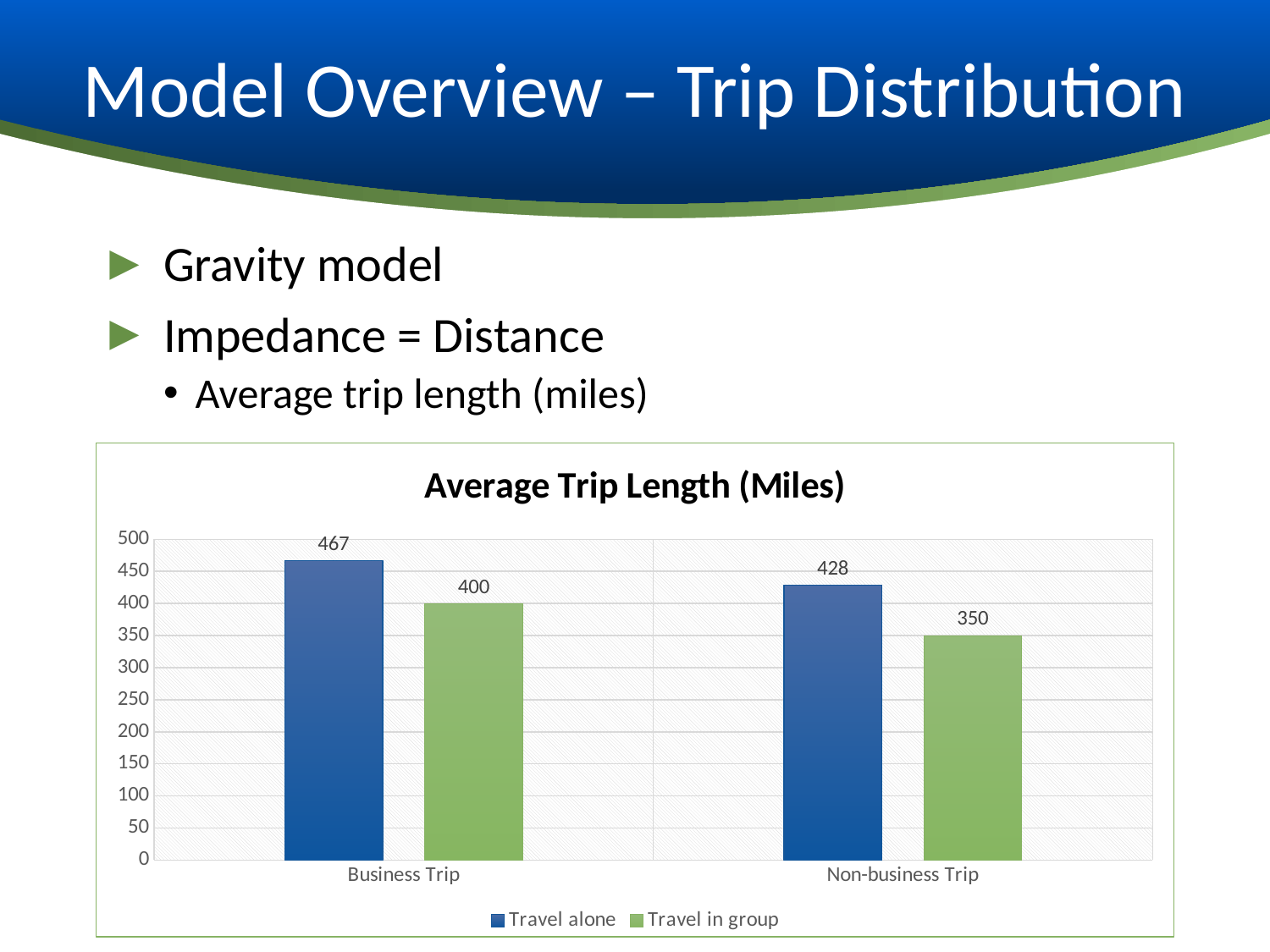
What is the difference between Travel alone and Travel in group for Business Trip? 67 What is the average trip length for Travel alone on a Non-business Trip? 428 Which bar has the lowest value in the chart? Travel in group, Non-business Trip How many categories are shown on the x axis? 2 What is the difference between Travel alone and Travel in group for Non-business Trip? 78 Which bar has the highest value in the chart? Travel alone, Business Trip Which is larger: Travel in group for Business Trip or Travel alone for Non-business Trip? Travel alone for Non-business Trip How many series does the legend list? 2 What is the average trip length for Travel alone on a Business Trip? 467 What is the average trip length for Travel in group on a Non-business Trip? 350 What type of chart is shown on the slide? Bar chart What is the average trip length for Travel in group on a Business Trip? 400